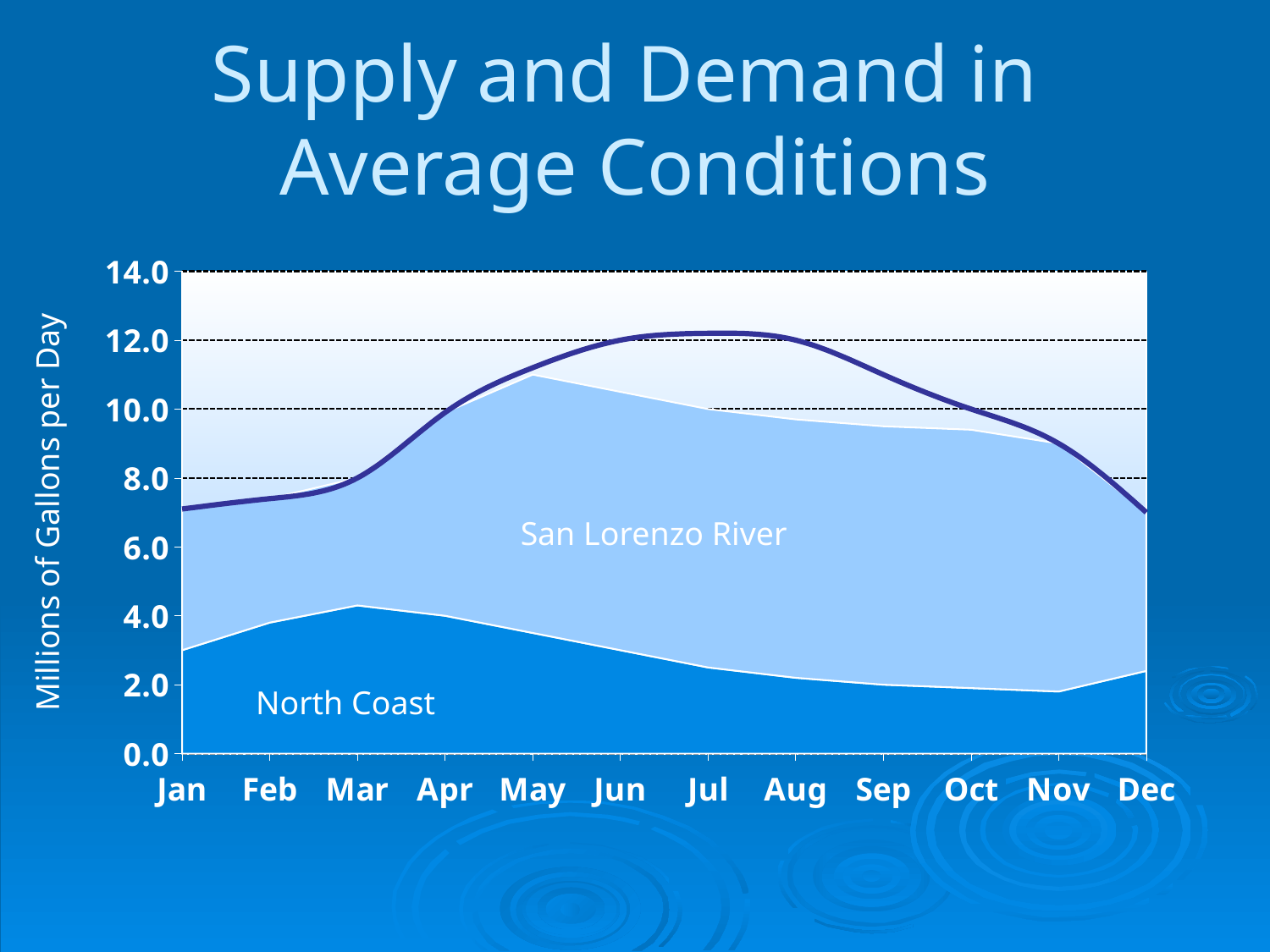
What is the title of the chart on the slide? Supply and Demand in Average Conditions What is the label on the vertical axis? Millions of Gallons per Day Does the North Coast supply rise or fall from Mar to Nov? Fall Is the combined supply (top of the San Lorenzo River area) in May greater or less than 10.0? greater Is the North Coast value in Jan greater or less than 4.0? less Is the demand line value in Jan greater or less than 8.0? less In which month is the North Coast supply highest? Mar How many months are shown along the x axis? 12 Does the demand line rise or fall from Jan to Jul? Rise What kind of chart is shown on the slide? Combination area and line chart